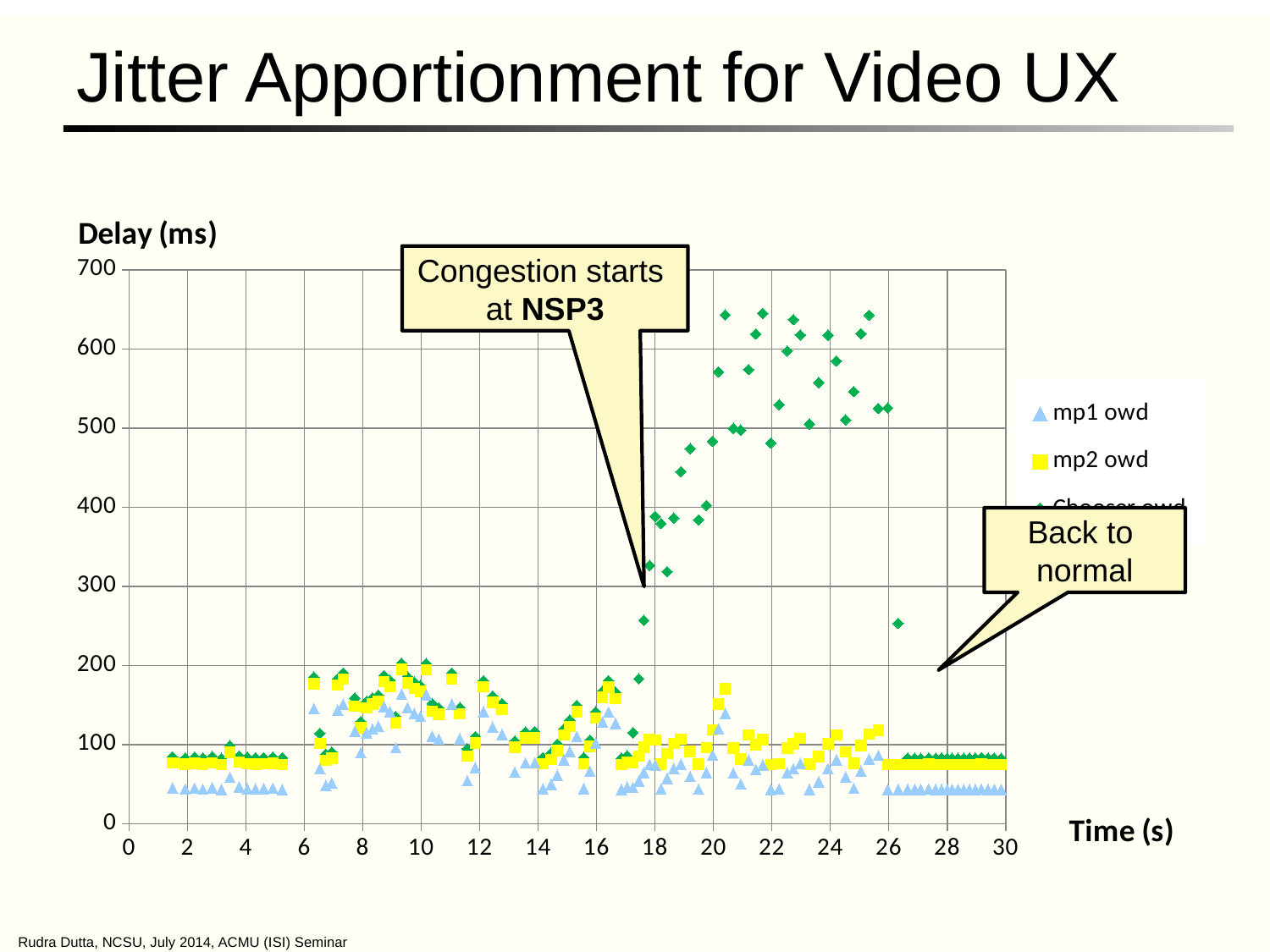
Which series has the highest values between 18 s and 26 s? the green diamond series Between 17 s and 20 s, do the values of the green diamond series rise or fall? rise Is the value of the green diamond series at time 22 s greater or less than 400? greater What is the label on the vertical axis? Delay (ms) Is the value for mp1 owd at time 2 s greater or less than 100? less Is the value of the green diamond series at time 2 s greater or less than 200? less What is the first series listed in the legend? mp1 owd How many series does the legend list? 3 What kind of chart is shown on the slide? scatter chart At time 20 s, which is larger: mp1 owd or mp2 owd? mp2 owd